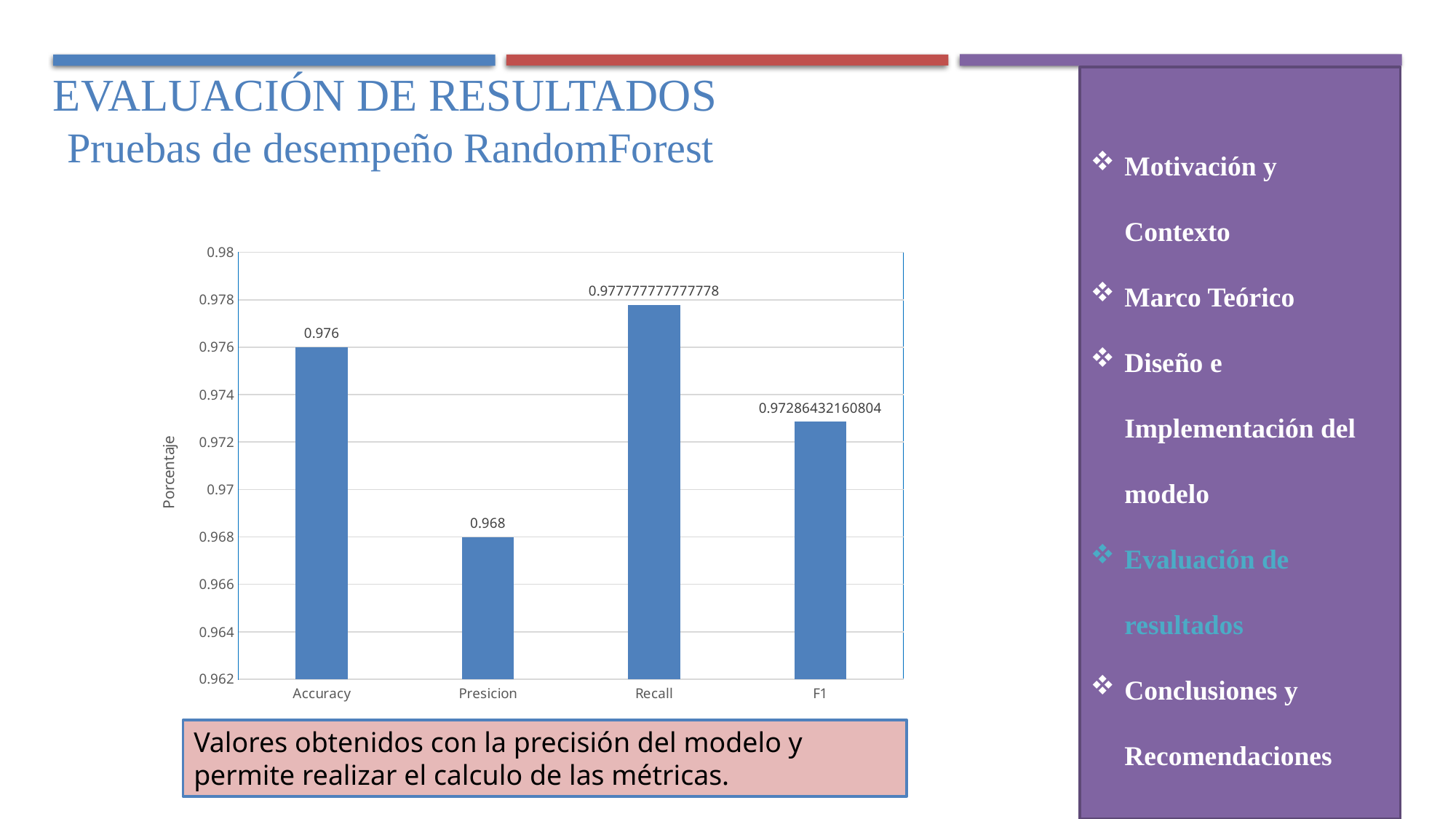
Is the value for Presicion greater or less than 0.97? less What is the value for Accuracy? 0.976 What is the value for Presicion? 0.968 Which category has the highest value? Recall Which category has the lowest value? Presicion What is the value for Recall? 0.977777777777778 What kind of chart is shown on the slide? bar chart What is the value for F1? 0.97286432160804 Which is larger, the value for Accuracy or the value for F1? Accuracy How many categories are shown on the x axis? 4 What is the difference between the values for Accuracy and Presicion? 0.008 What is the label of the vertical axis? Porcentaje